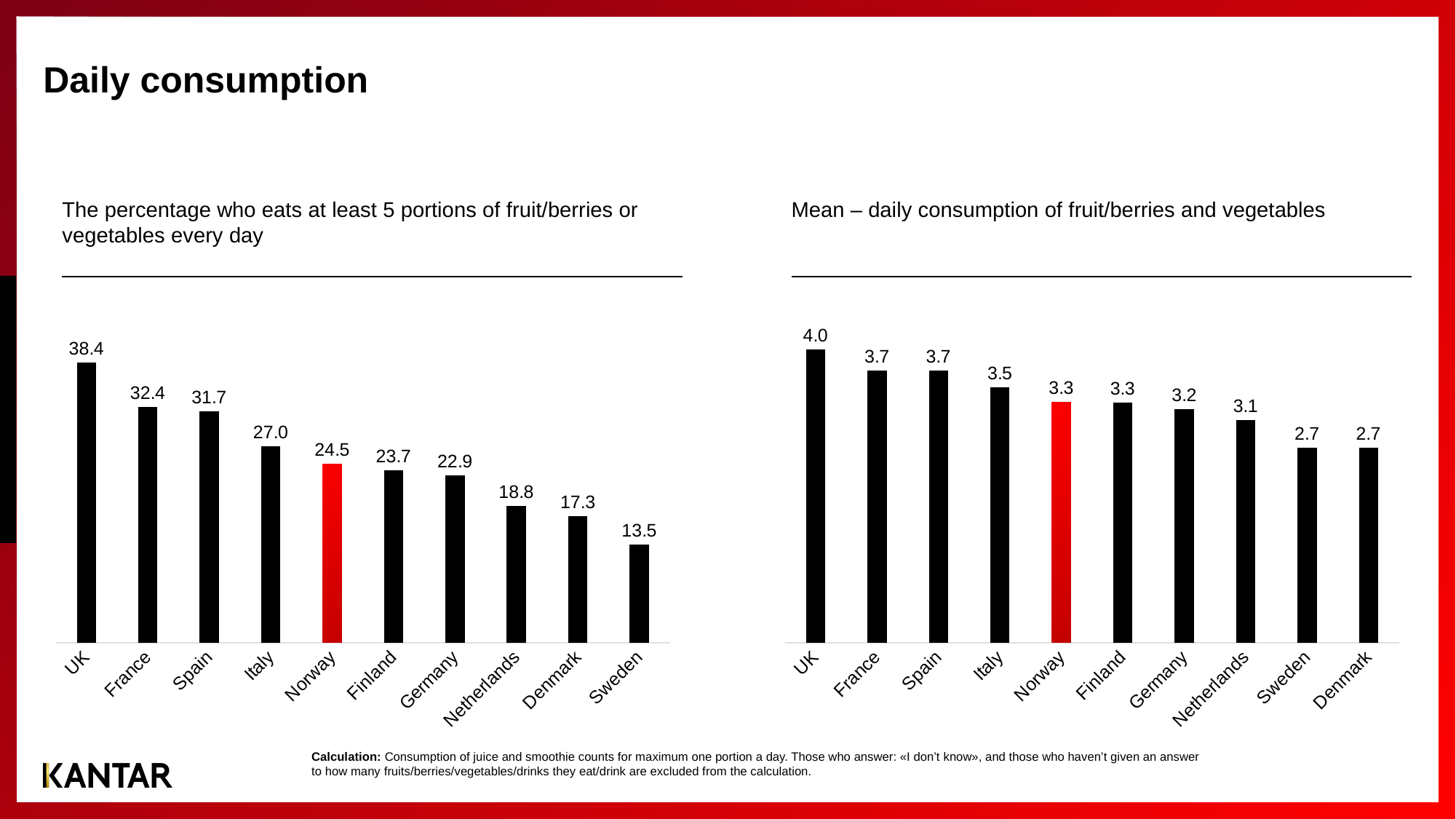
In the left chart (percentage who eats at least 5 portions every day), which is larger, the value for Finland or the value for Germany? Finland In the left chart (percentage who eats at least 5 portions every day), what is the difference between the values for UK and Sweden? 24.9 In the right chart (mean daily consumption), which country has the highest value? UK In the right chart (mean daily consumption), what is the difference between the values for UK and Netherlands? 0.9 In the left chart (percentage who eats at least 5 portions every day), how many countries are shown? 10 In the left chart (percentage who eats at least 5 portions every day), which country's bar is coloured red? Norway In the right chart (mean daily consumption), what is the value for Italy? 3.5 In the right chart (mean daily consumption), which is larger, the value for Germany or the value for Sweden? Germany In the left chart (percentage who eats at least 5 portions every day), which country has the lowest value? Sweden In the left chart (percentage who eats at least 5 portions every day), what is the value for Norway? 24.5 In the left chart (percentage who eats at least 5 portions every day), which country has the highest value? UK What kind of chart is the right chart (mean daily consumption)? Bar chart